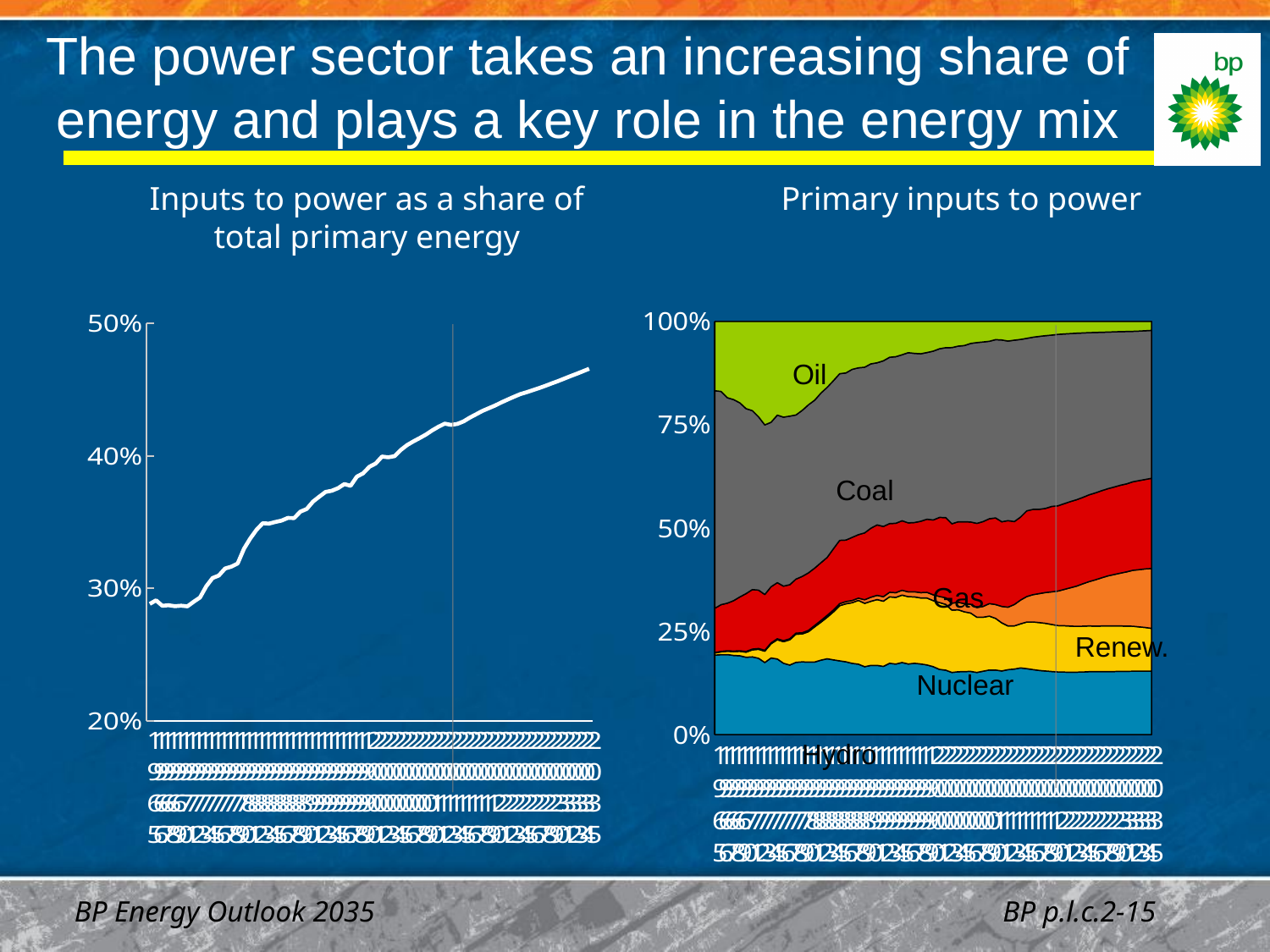
In the right chart, 'Primary inputs to power', does the share of Renew. grow or shrink from left to right? grow In the right chart, 'Primary inputs to power', which fuel is at the top of the stack? Oil In the left chart, 'Inputs to power as a share of total primary energy', does the line rise or fall from left to right? rise How many fuel categories are labelled in the right chart, 'Primary inputs to power'? 6 In the right chart, 'Primary inputs to power', which fuel is at the bottom of the stack? Hydro In the right chart, 'Primary inputs to power', does the share of Oil grow or shrink from left to right? shrink In the left chart, 'Inputs to power as a share of total primary energy', is the value at the start of the line greater or less than 30%? less What kind of chart is the right chart, 'Primary inputs to power'? stacked area chart In the left chart, 'Inputs to power as a share of total primary energy', what is the highest value shown on the y axis? 50% In the right chart, 'Primary inputs to power', is the top of the Hydro band at the right edge greater or less than 25%? less In the left chart, 'Inputs to power as a share of total primary energy', is the value at the end of the line greater or less than 40%? greater What kind of chart is the left chart, 'Inputs to power as a share of total primary energy'? line chart